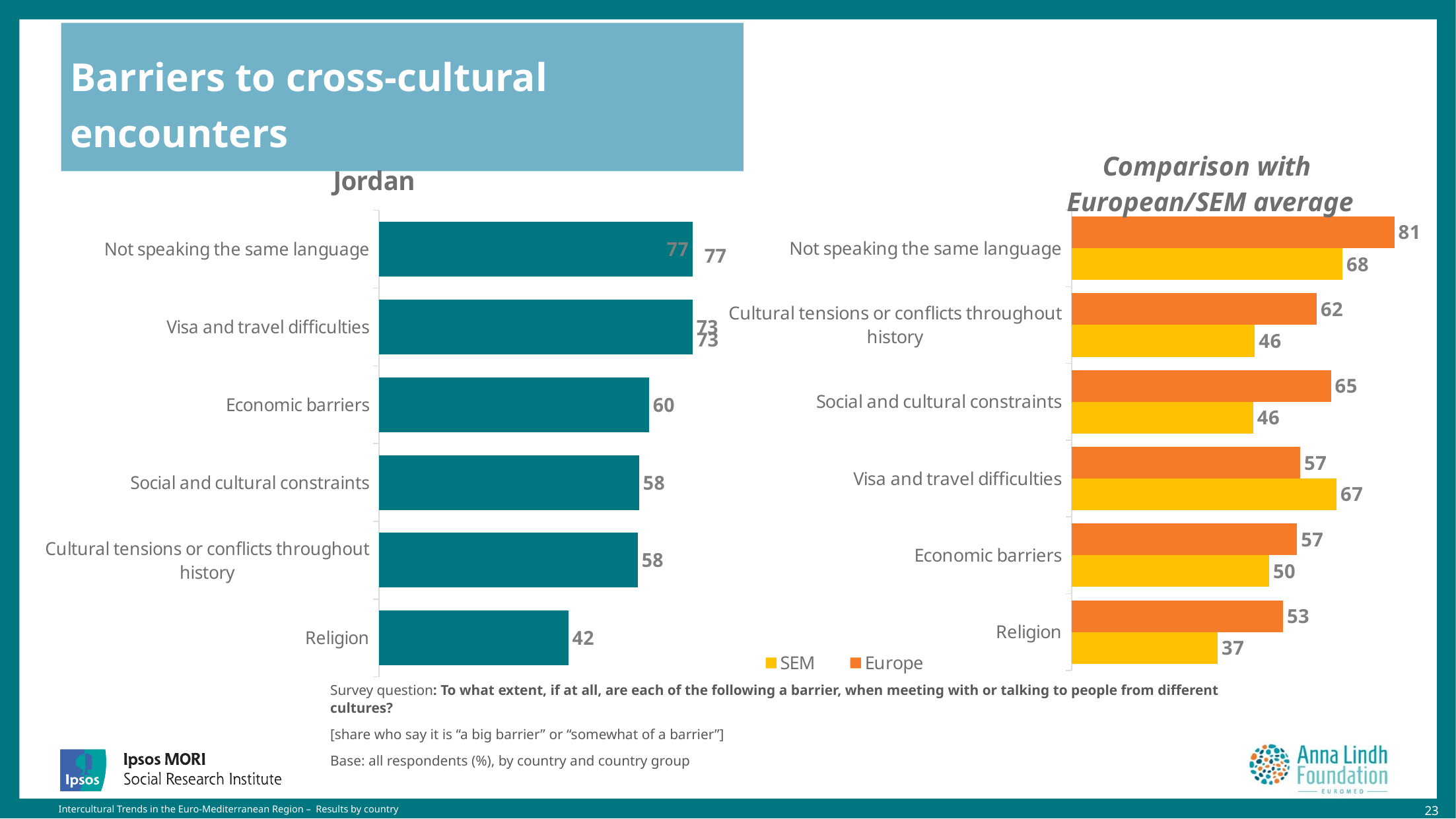
In the Jordan chart, what is the difference between Not speaking the same language and Visa and travel difficulties? 4 In the Jordan chart, what is the value for Religion? 42 In the Jordan chart, what is the value for Economic barriers? 60 In the Comparison with European/SEM average chart, what is the Europe value for Not speaking the same language? 81 In the Comparison with European/SEM average chart, what is the difference between the Europe and SEM values for Social and cultural constraints? 19 How many barriers are shown in the Jordan chart? 6 What type of chart is the Jordan chart? Bar chart In the Comparison with European/SEM average chart, which is larger for Visa and travel difficulties, SEM or Europe? SEM In the Jordan chart, which barrier has the highest value? Not speaking the same language In the Comparison with European/SEM average chart, what is the SEM value for Religion? 37 In the Jordan chart, which barrier has the lowest value? Religion How many series does the legend of the Comparison with European/SEM average chart list? 2